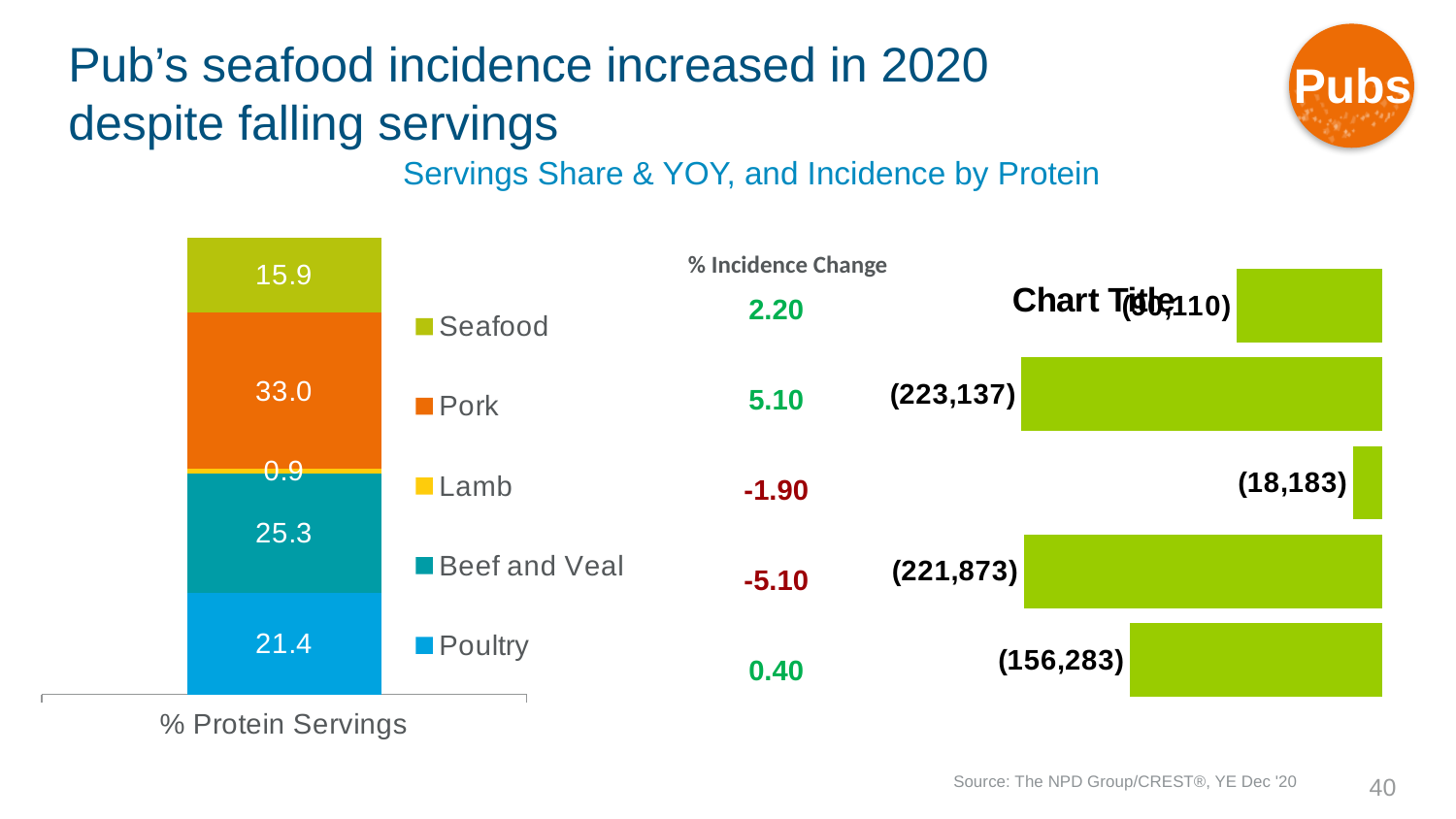
In the stacked bar chart on the left (% Protein Servings), what is the difference between the Pork and Beef and Veal values? 7.7 How many bars are plotted in the horizontal bar chart on the right? 5 How many series does the legend of the stacked bar chart on the left list? 5 In the stacked bar chart on the left (% Protein Servings), what is the value for Seafood? 15.9 In the horizontal bar chart on the right, what is the data label on the second bar from the top? (223,137) In the stacked bar chart on the left (% Protein Servings), what is the value for Pork? 33.0 In the stacked bar chart on the left (% Protein Servings), which protein has the smallest share? Lamb In the stacked bar chart on the left (% Protein Servings), which is larger: Poultry or Beef and Veal? Beef and Veal What is the total of all segments in the stacked bar on the left (% Protein Servings)? 96.5 In the stacked bar chart on the left (% Protein Servings), which protein has the largest share? Pork What kind of chart is the chart on the left (% Protein Servings)? Stacked bar chart In the horizontal bar chart on the right, what is the data label on the bottom bar? (156,283)